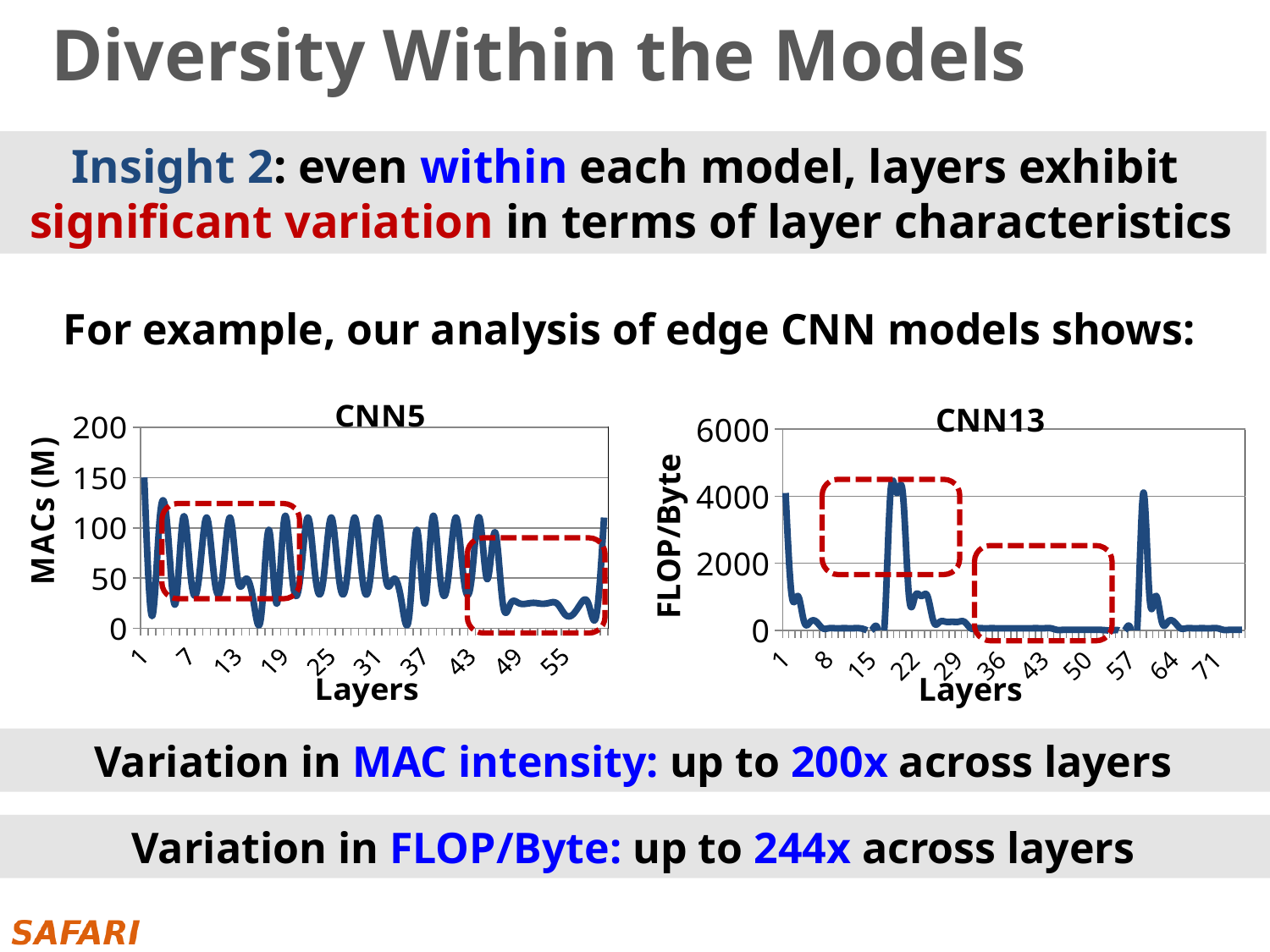
In the CNN13 chart, is the value for layer 8 greater or less than 2000? less What kind of chart is the CNN13 chart? line chart What kind of chart is the CNN5 chart? line chart In the CNN13 chart, what is the label of the y axis? FLOP/Byte In the CNN5 chart, what is the label of the y axis? MACs (M) In the CNN13 chart, is the value for layer 1 larger or smaller than the value for layer 43? larger In the CNN5 chart, is the value for layer 49 greater or less than 50? less In the CNN5 chart, is the value for layer 49 larger or smaller than the value for layer 1? smaller In the CNN5 chart, is the value for layer 1 greater or less than 100? greater How many charts are shown on the slide? 2